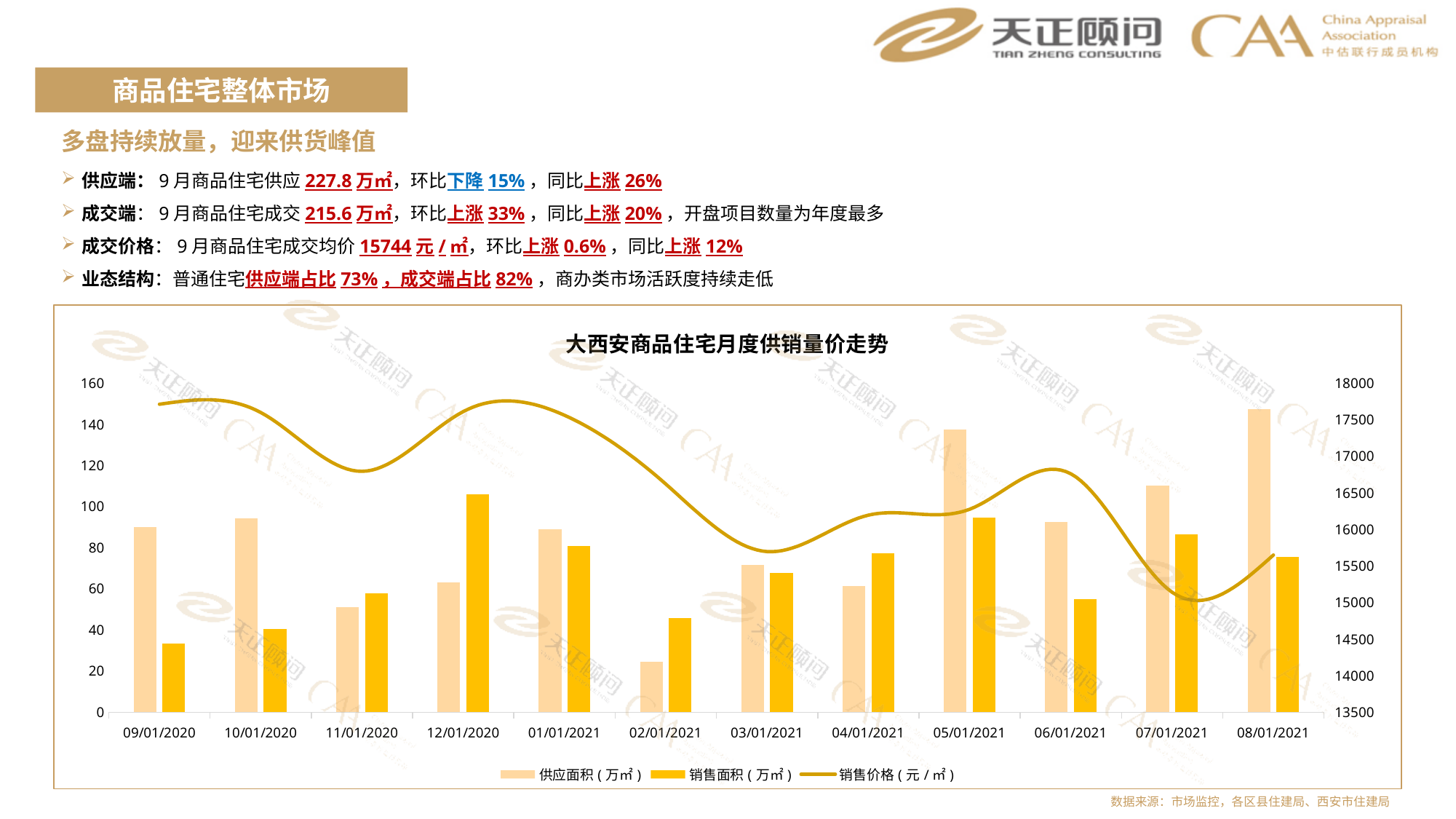
In which month is 销售面积 highest? 12/01/2020 Does the 销售价格 line rise or fall from 12/01/2020 to 03/01/2021? fall In which month is 供应面积 lowest? 02/01/2021 How many months are shown on the x axis of the chart? 12 For 06/01/2021, which is larger, 供应面积 or 销售面积? 供应面积 What kind of chart is shown on the slide? Combined bar and line chart What is the title of the chart? 大西安商品住宅月度供销量价走势 Is the 销售价格 value for 09/01/2020 greater or less than 17500? greater In which month is 供应面积 highest? 08/01/2021 How many series does the chart legend list? 3 Which series is drawn as a line in the chart? 销售价格（元/㎡） Is the 供应面积 value for 02/01/2021 greater or less than 40? less